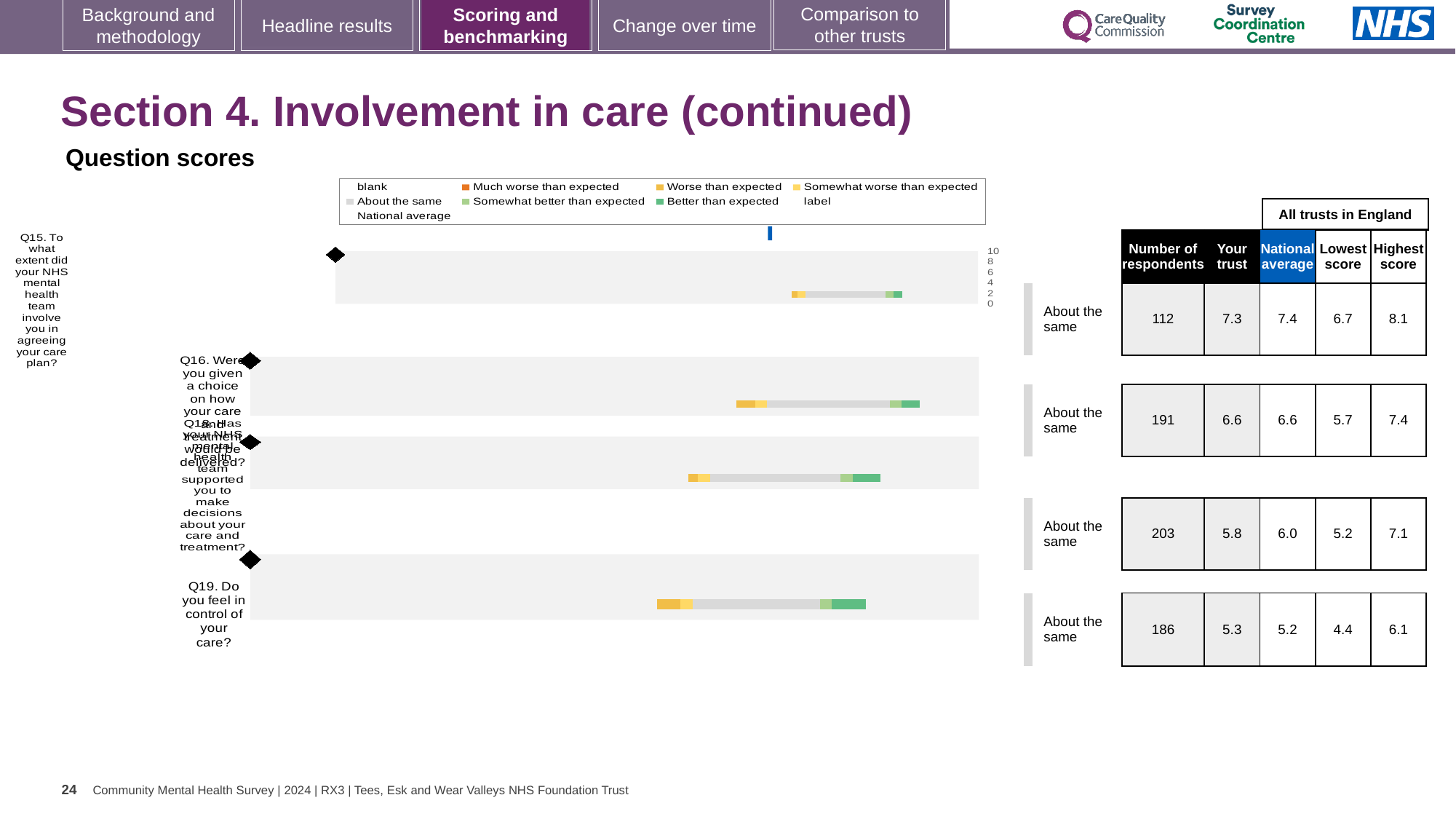
What is the title of the table column shown in blue? National average What is the difference between the highest score (8.1) and the lowest score (6.7) for Q15? 1.4 How many respondents are shown for Q18 (Has your NHS mental health team supported you to make decisions about your care and treatment?)? 203 What is the national average score for Q19 (Do you feel in control of your care?)? 5.2 Which question has the highest 'Your trust' score? Q15 What kind of chart is used to show the question scores on this slide? bar chart For Q18, which is larger: the 'Your trust' score or the national average? National average How many questions (categories) are plotted in the question scores chart? 4 How many entries does the legend of the question scores chart list? 9 What benchmark category is shown for Q16 (Were you given a choice on how your care and treatment would be delivered?)? About the same What is the 'Your trust' score for Q15 (To what extent did your NHS mental health team involve you in agreeing your care plan?)? 7.3 Which question has the lowest 'Your trust' score? Q19